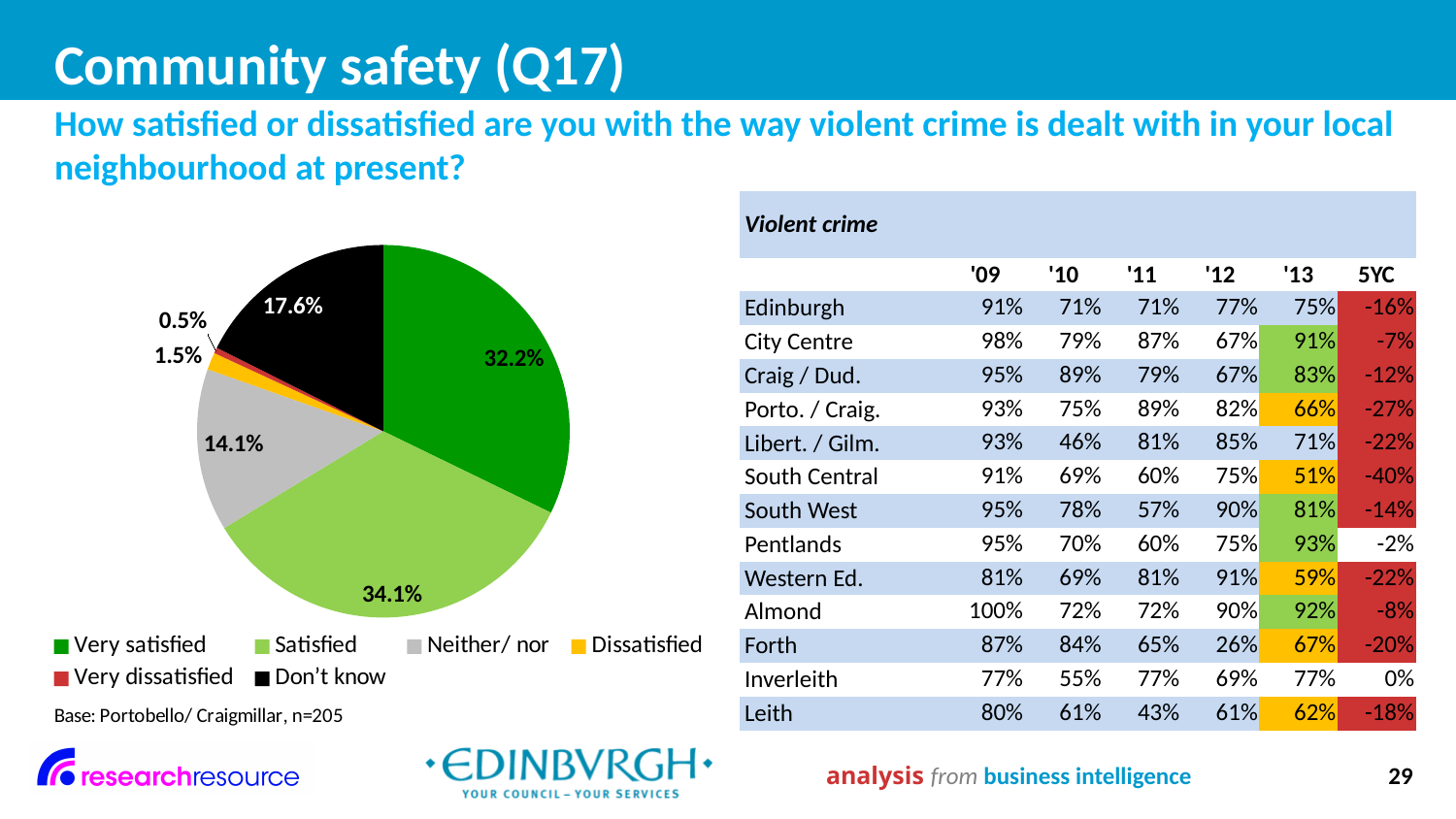
What type of chart is shown on the slide? Pie chart What percentage of respondents answered 'Neither/ nor'? 14.1% Which is larger, the 'Don't know' share or the 'Neither/ nor' share? Don't know What is the difference between the 'Satisfied' and 'Very satisfied' shares? 1.9% What percentage of respondents answered 'Don't know'? 17.6% Which category has the smallest share of the pie? Very dissatisfied What percentage of respondents are very dissatisfied? 0.5% What percentage of respondents are satisfied? 34.1% Which category has the largest share of the pie? Satisfied How many categories does the pie chart legend list? 6 What is the base sample size stated below the pie chart? n=205 What percentage of respondents are very satisfied? 32.2%